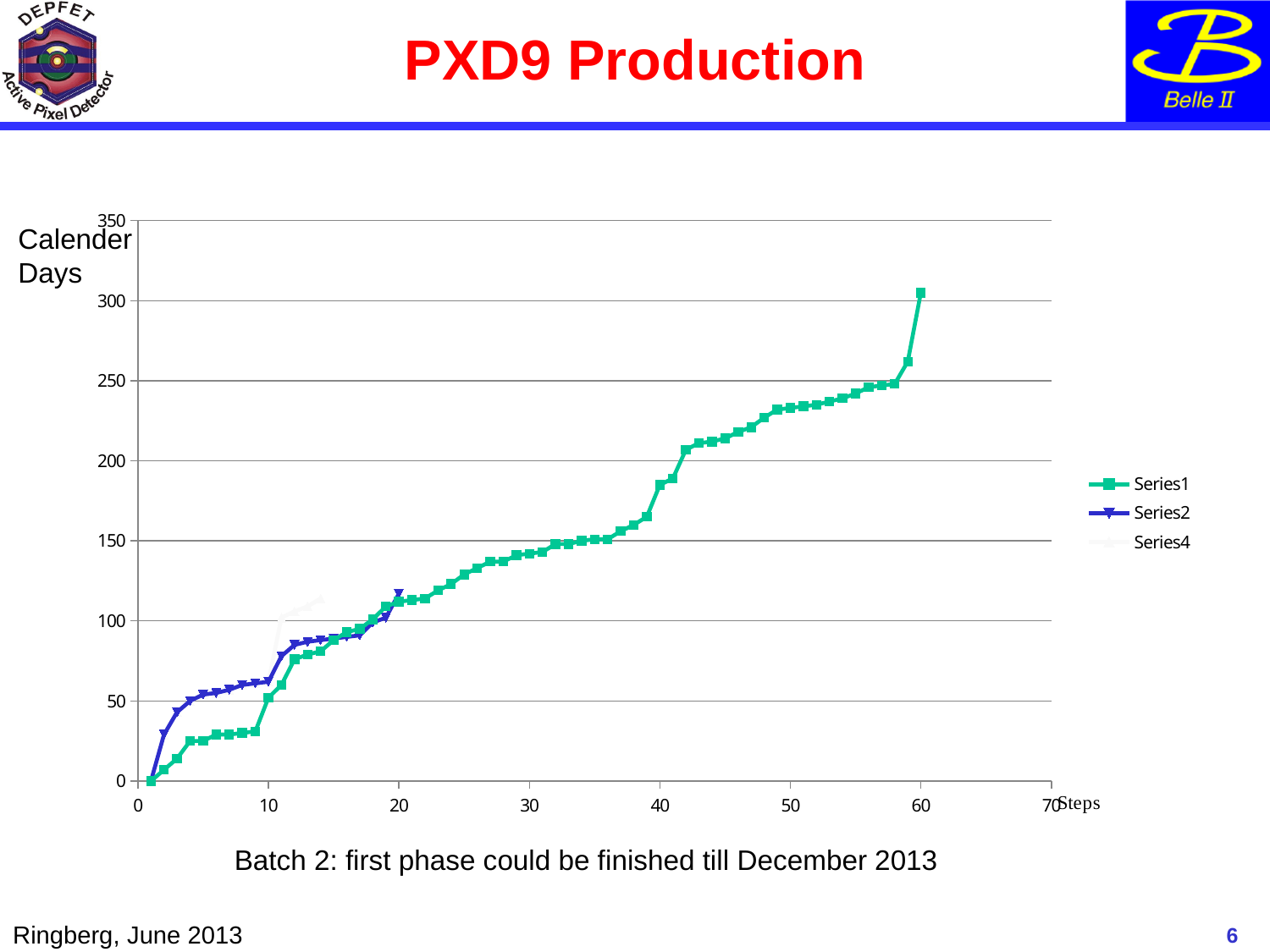
Is the value of Series1 at step 40 greater or less than 150? greater How many series does the legend list? 3 Is the value of Series1 at step 60 greater or less than 300? greater What kind of chart is shown on the slide? line chart Is the value of Series1 at step 50 greater or less than 250? less At step 5, which series has the larger value, Series1 or Series2? Series2 What is the label of the horizontal axis? Steps What is the label of the vertical axis? Calender Days Do the values of Series1 rise or fall as the steps increase? rise